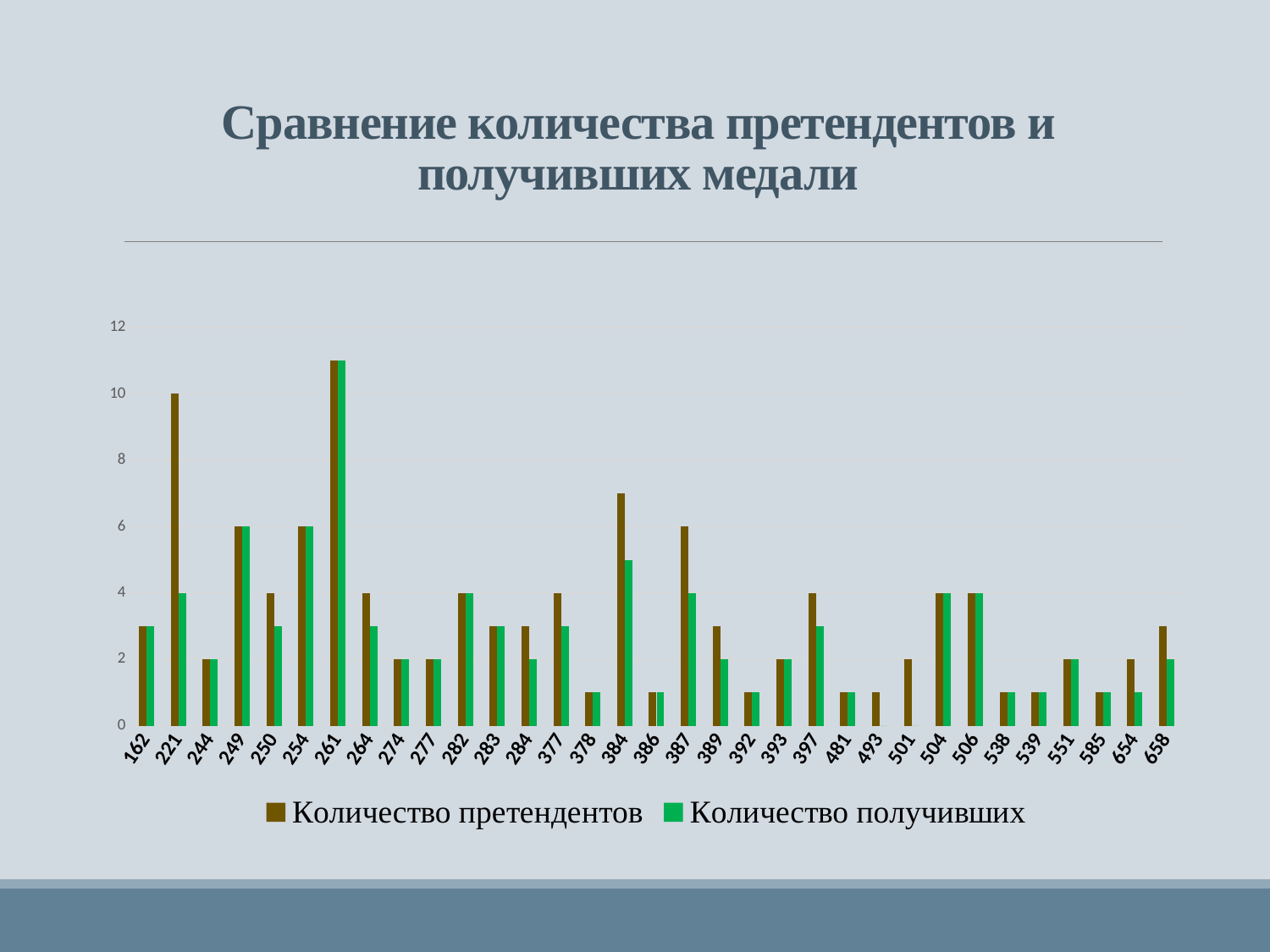
How many series does the legend list? 2 How many categories are shown along the x axis? 33 Is the value of Количество претендентов for category 261 greater or less than 10? greater Which category has the highest value for Количество получивших? 261 Is the value of Количество претендентов for category 384 greater or less than 6? greater What is the value of Количество претендентов for category 504? 4 What kind of chart is shown on the slide? bar chart What is the value of Количество претендентов for category 221? 10 Which category has the highest value for Количество претендентов? 261 What is the value of Количество получивших for category 249? 6 What is the difference between Количество претендентов and Количество получивших for category 221? 6 For category 221, which is larger: Количество претендентов or Количество получивших? Количество претендентов